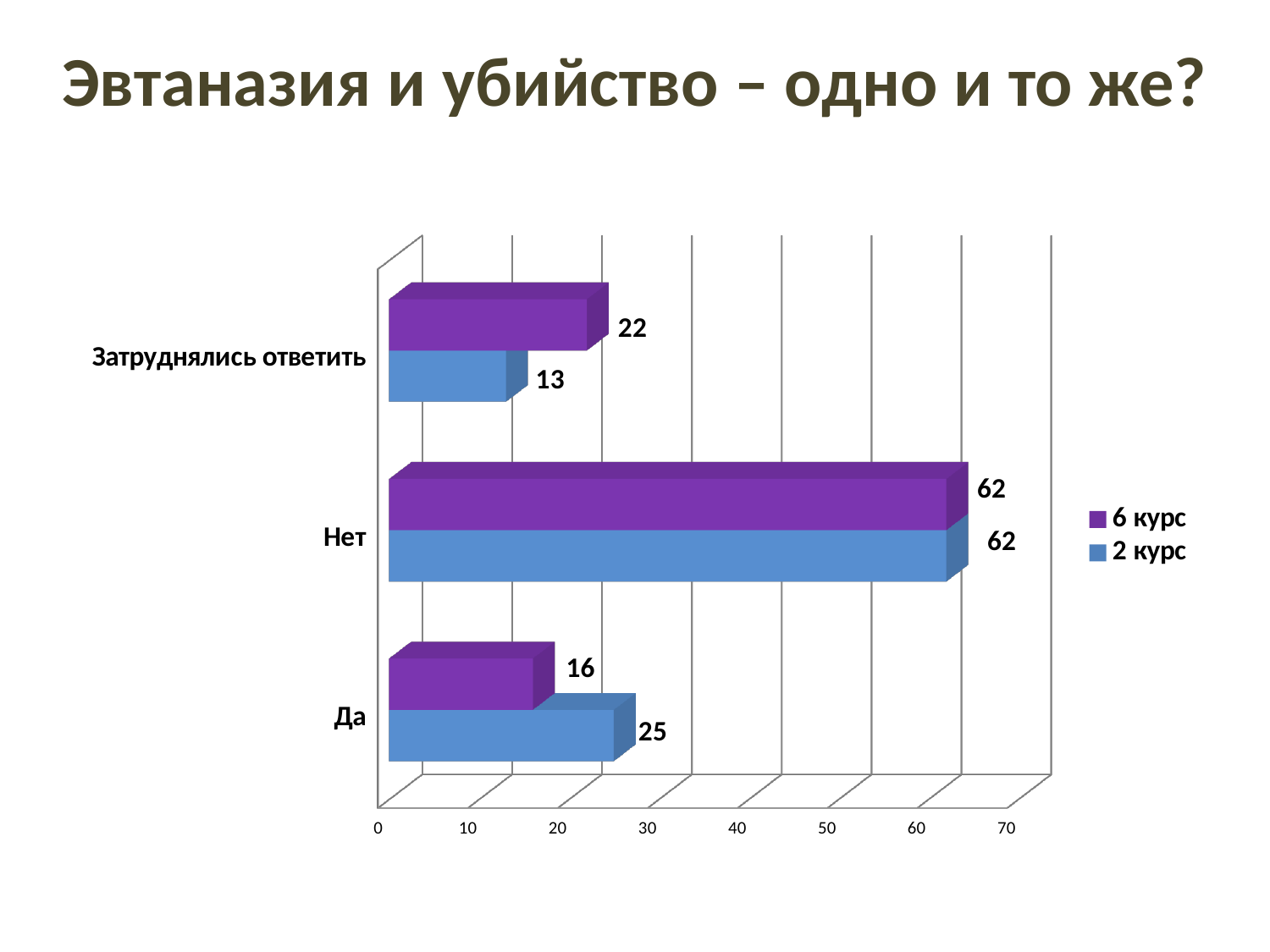
Which category has the lowest value for "6 курс"? Да How many series does the legend list? 2 What is the value for "2 курс" in the "Да" category? 25 What is the difference between the "2 курс" and "6 курс" values in the "Да" category? 9 What is the value for "6 курс" in the "Да" category? 16 What is the value for "6 курс" in the "Затруднялись ответить" category? 22 What is the title of the slide? Эвтаназия и убийство – одно и то же? What is the value for "2 курс" in the "Затруднялись ответить" category? 13 In the "Затруднялись ответить" category, which series has the larger value, "6 курс" or "2 курс"? 6 курс How many categories are shown on the chart? 3 What kind of chart is shown on the slide? Bar chart Which category has the highest value for "2 курс"? Нет